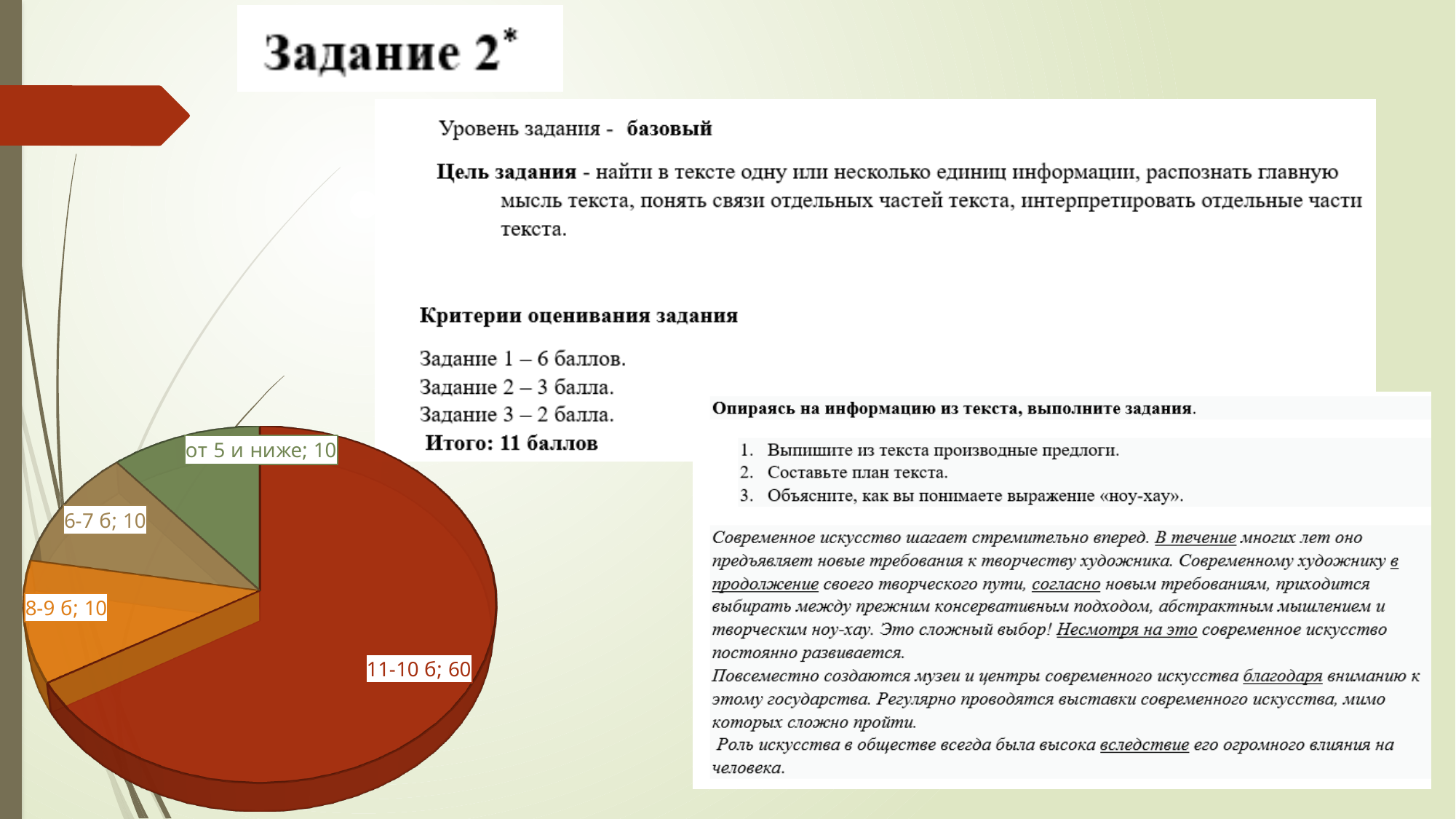
What is the value for the "от 5 и ниже" slice in the pie chart? 10 What is the value for the "6-7 б" slice in the pie chart? 10 What is the difference between the "11-10 б" slice and the "8-9 б" slice? 50 How many slices does the pie chart have? 4 What is the total of all the slice values in the pie chart? 90 Which is larger in the pie chart: the "11-10 б" slice or the "6-7 б" slice? 11-10 б Which slice of the pie chart is the largest? 11-10 б What kind of chart is shown on the slide? pie chart What is the value for the "8-9 б" slice in the pie chart? 10 What colour is the "8-9 б" slice of the pie chart? orange What is the value for the "11-10 б" slice in the pie chart? 60 What colour is the largest slice of the pie chart? red